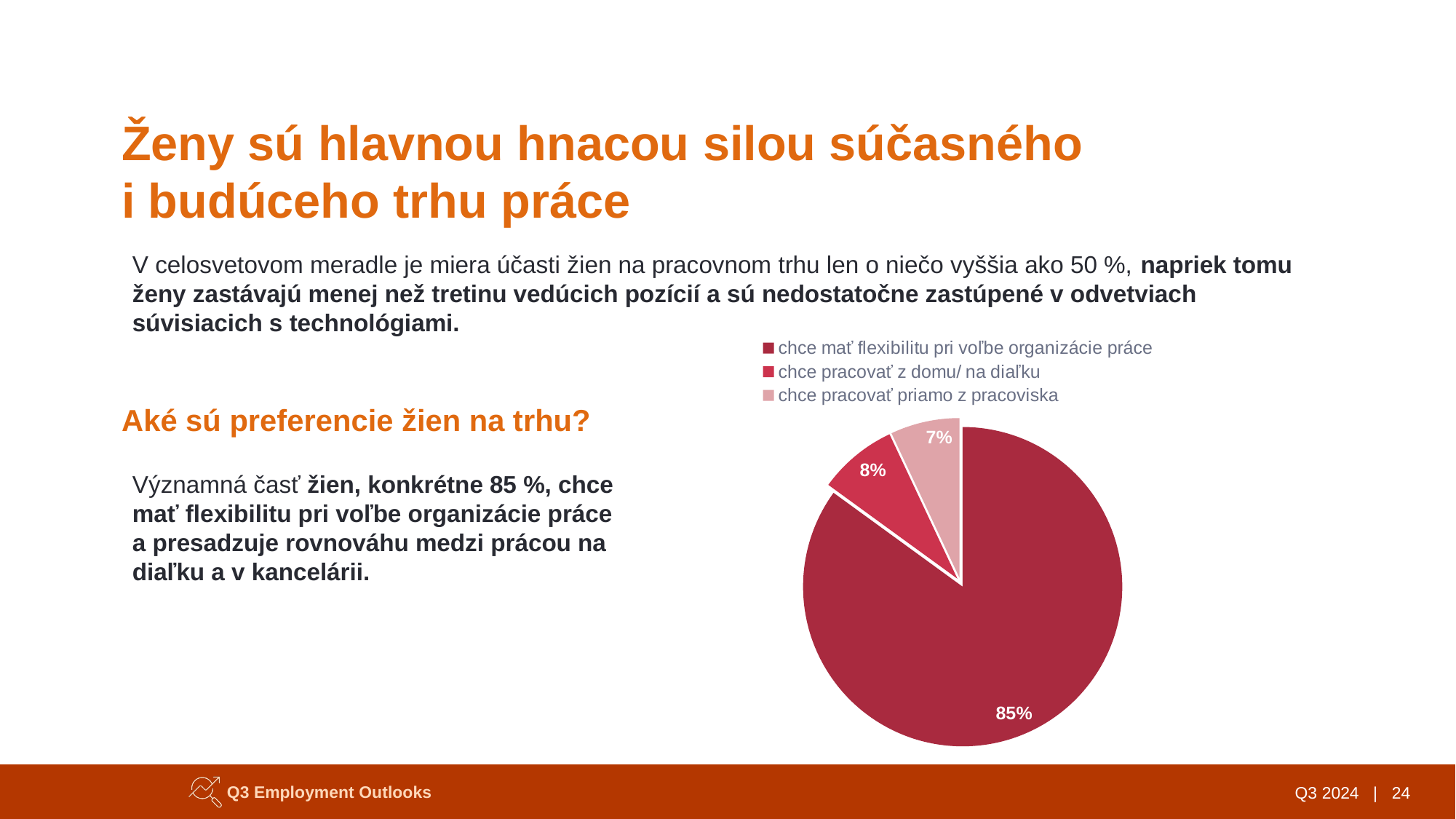
What share of the pie is labelled "chce mať flexibilitu pri voľbe organizácie práce"? 85% How many slices does the pie chart have? 3 What is the combined share of the two smaller slices, "chce pracovať z domu/ na diaľku" and "chce pracovať priamo z pracoviska"? 15% Which legend entry is shown in the lightest pink colour? chce pracovať priamo z pracoviska Which category has the largest slice of the pie? chce mať flexibilitu pri voľbe organizácie práce What kind of chart is shown on the slide? pie chart How many entries does the legend list? 3 What share of the pie is labelled "chce pracovať z domu/ na diaľku"? 8% What share of the pie is labelled "chce pracovať priamo z pracoviska"? 7% Which category has the smallest slice of the pie? chce pracovať priamo z pracoviska What is the difference in percentage points between the "chce mať flexibilitu pri voľbe organizácie práce" slice and the "chce pracovať z domu/ na diaľku" slice? 77 Which is larger: the slice for "chce pracovať z domu/ na diaľku" or the slice for "chce pracovať priamo z pracoviska"? chce pracovať z domu/ na diaľku